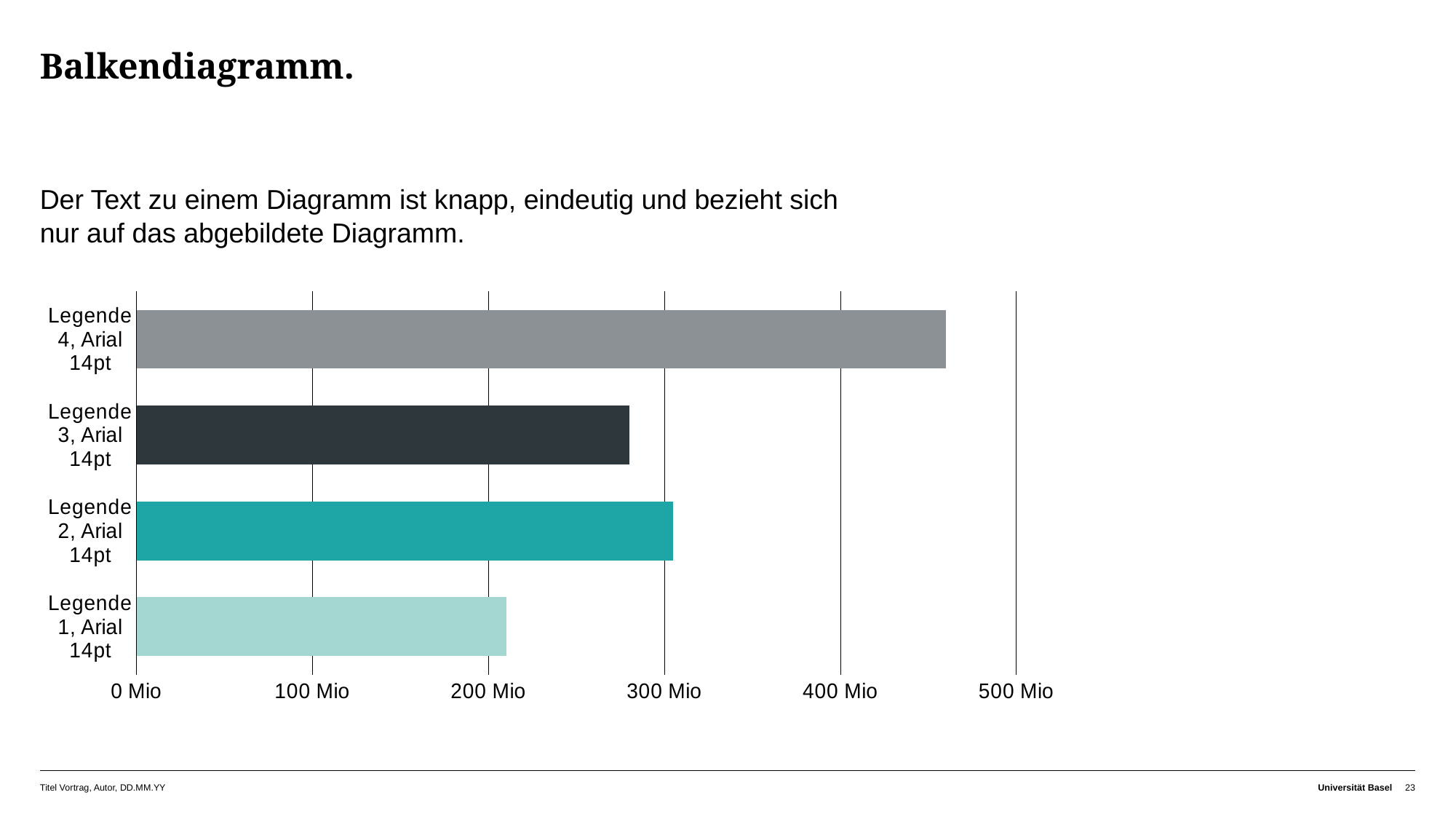
Which is larger, the value for Legende 1, Arial 14pt or the value for Legende 4, Arial 14pt? Legende 4, Arial 14pt Is the value for Legende 3, Arial 14pt greater or less than 300 Mio? less Is the value for Legende 1, Arial 14pt greater or less than 300 Mio? less What kind of chart is shown on the slide? bar chart Is the value for Legende 4, Arial 14pt greater or less than 400 Mio? greater What is the title of the slide containing the chart? Balkendiagramm. How many bars does the chart show? 4 Which is larger, the value for Legende 2, Arial 14pt or the value for Legende 3, Arial 14pt? Legende 2, Arial 14pt Which category has the lowest value? Legende 1, Arial 14pt Which category has the highest value? Legende 4, Arial 14pt